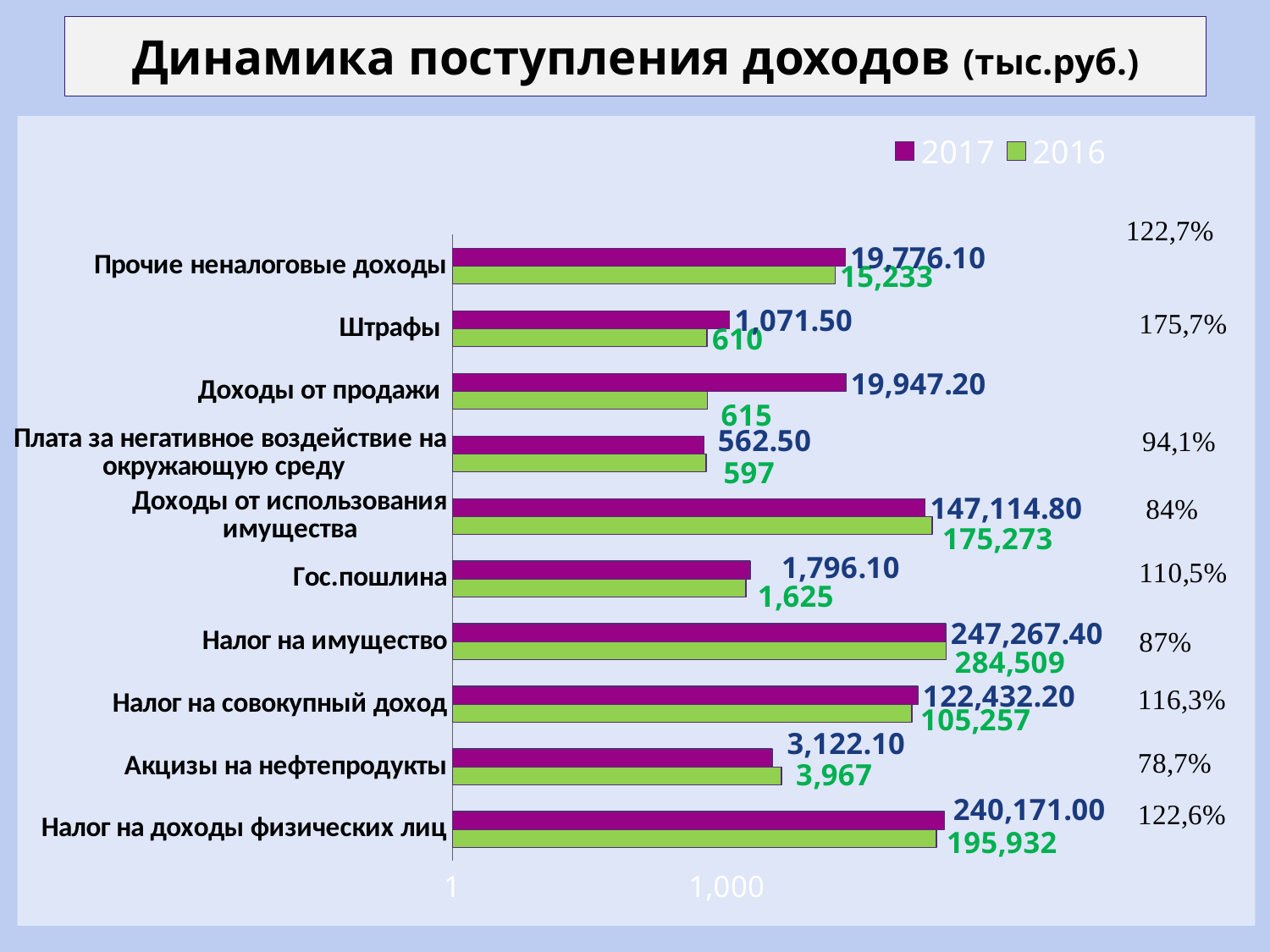
What is the 2016 value for Доходы от использования имущества? 175,273 How many series does the legend list? 2 What kind of chart is shown on the slide? Bar chart What is the difference between the 2017 and 2016 values for Штрафы? 461.50 Which is larger for Налог на совокупный доход: the 2017 value or the 2016 value? 2017 How many categories are shown on the chart? 10 What is the difference between the 2016 and 2017 values for Акцизы на нефтепродукты? 844.90 What is the 2017 value for Налог на доходы физических лиц? 240,171.00 Which category has the highest 2016 value? Налог на имущество What is the 2016 value for Акцизы на нефтепродукты? 3,967 What is the 2017 value for Доходы от продажи? 19,947.20 Which category has the lowest 2017 value? Плата за негативное воздействие на окружающую среду